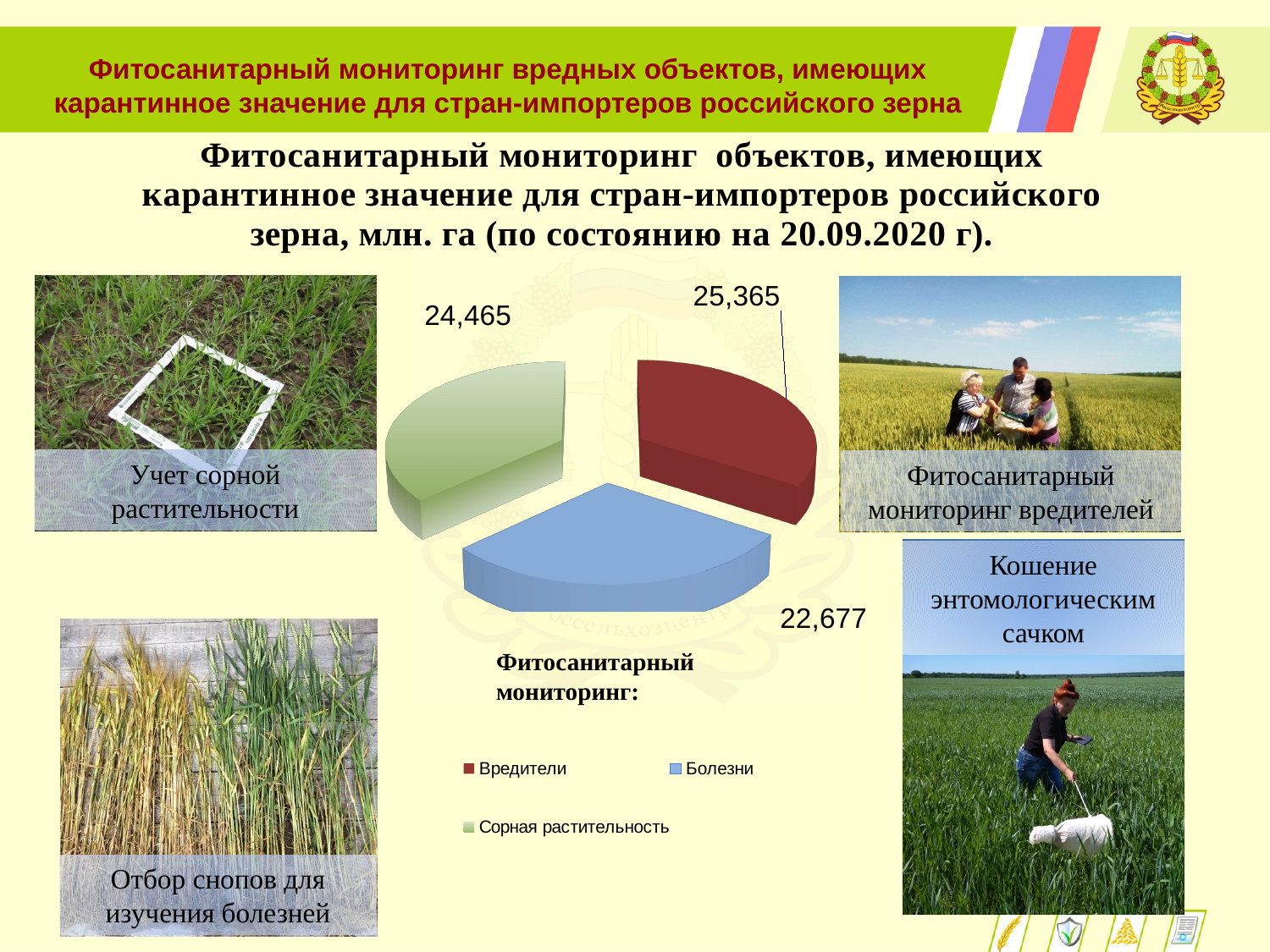
How many categories does the pie chart have? 3 Which category has the smallest slice in the pie chart? Болезни What is the value for Сорная растительность in the pie chart? 24,465 Which is larger: the value for Сорная растительность or the value for Болезни? Сорная растительность What is the total of all three slices in the pie chart? 72,507 What is the value for Вредители in the pie chart? 25,365 What is the difference between the values for Сорная растительность and Болезни? 1,788 Which colour represents Болезни in the pie chart? blue What is the difference between the values for Вредители and Болезни? 2,688 What is the value for Болезни in the pie chart? 22,677 What type of chart is shown on the slide? pie chart